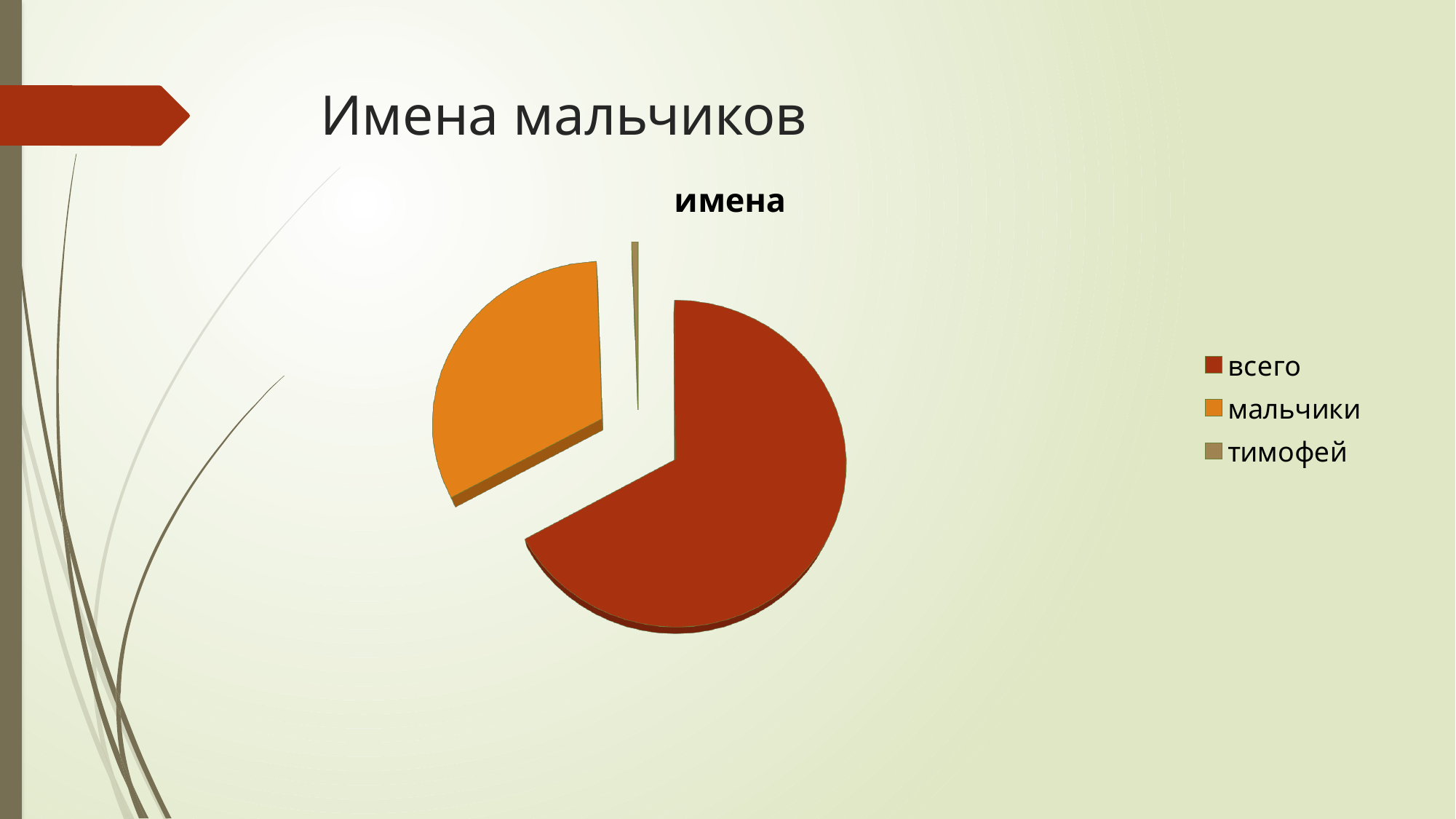
What kind of chart is shown on the slide? pie chart What colour is the slice for мальчики? orange How many entries does the legend list? 3 What is the title of the chart? имена Which slice is larger, всего or мальчики? всего Which slice is larger, мальчики or тимофей? мальчики Which slice of the pie chart is the largest? всего Which slice of the pie chart is the smallest? тимофей How many slices does the pie chart have? 3